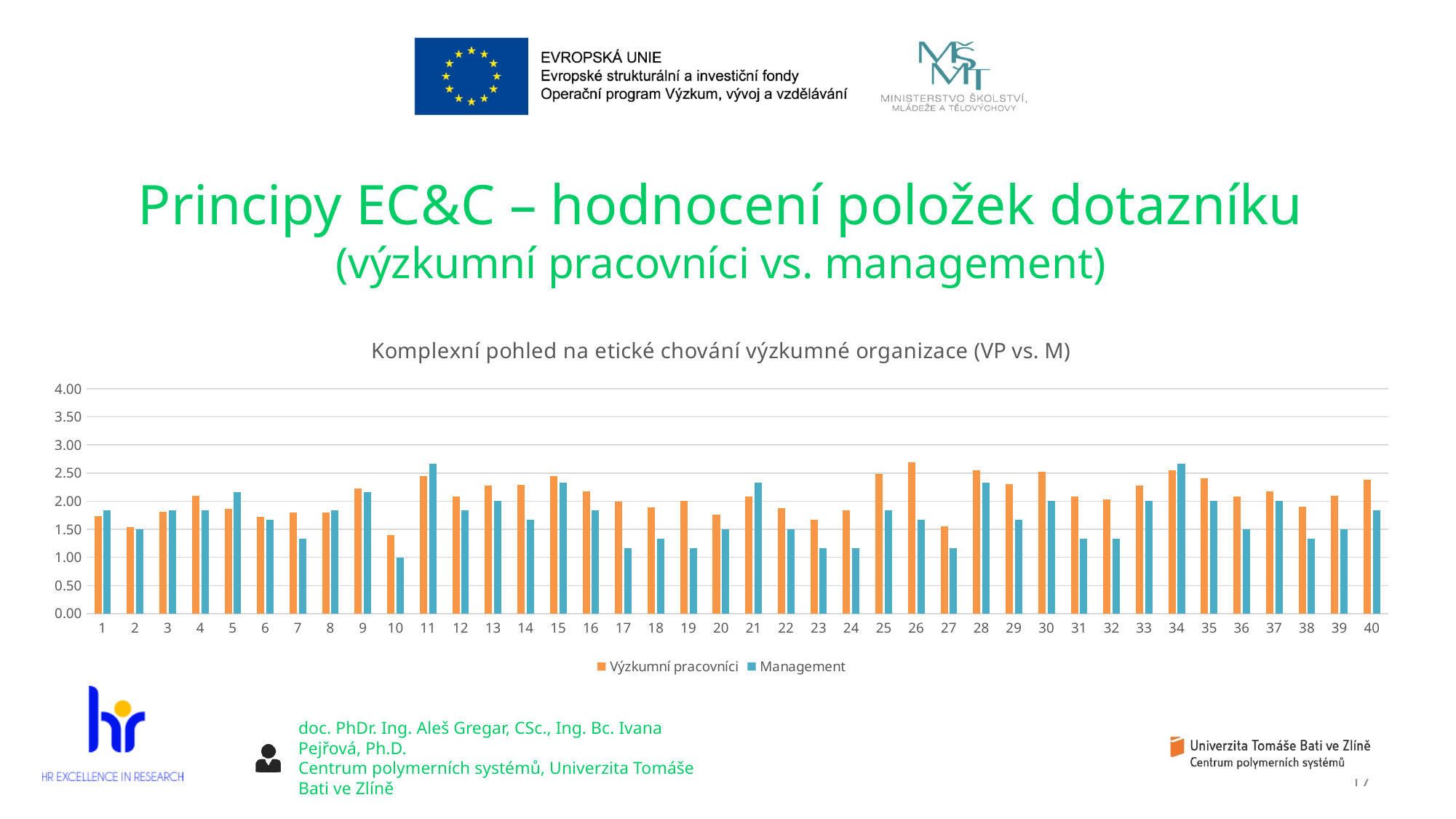
What is the title of the chart? Komplexní pohled na etické chování výzkumné organizace (VP vs. M) How many categories are plotted along the x axis of the chart? 40 Is the Výzkumní pracovníci value for category 26 greater or less than 2.50? greater Which category has the lowest Výzkumní pracovníci value? 10 What kind of chart is shown on the slide? bar chart For category 26, which series has the larger value, Výzkumní pracovníci or Management? Výzkumní pracovníci Which category has the lowest Management value? 10 Which series is shown in orange in the chart? Výzkumní pracovníci How many series does the chart's legend list? 2 For category 5, which series has the larger value, Výzkumní pracovníci or Management? Management Is the Management value for category 10 greater or less than 1.50? less Is the Management value for category 11 greater or less than 2.50? greater